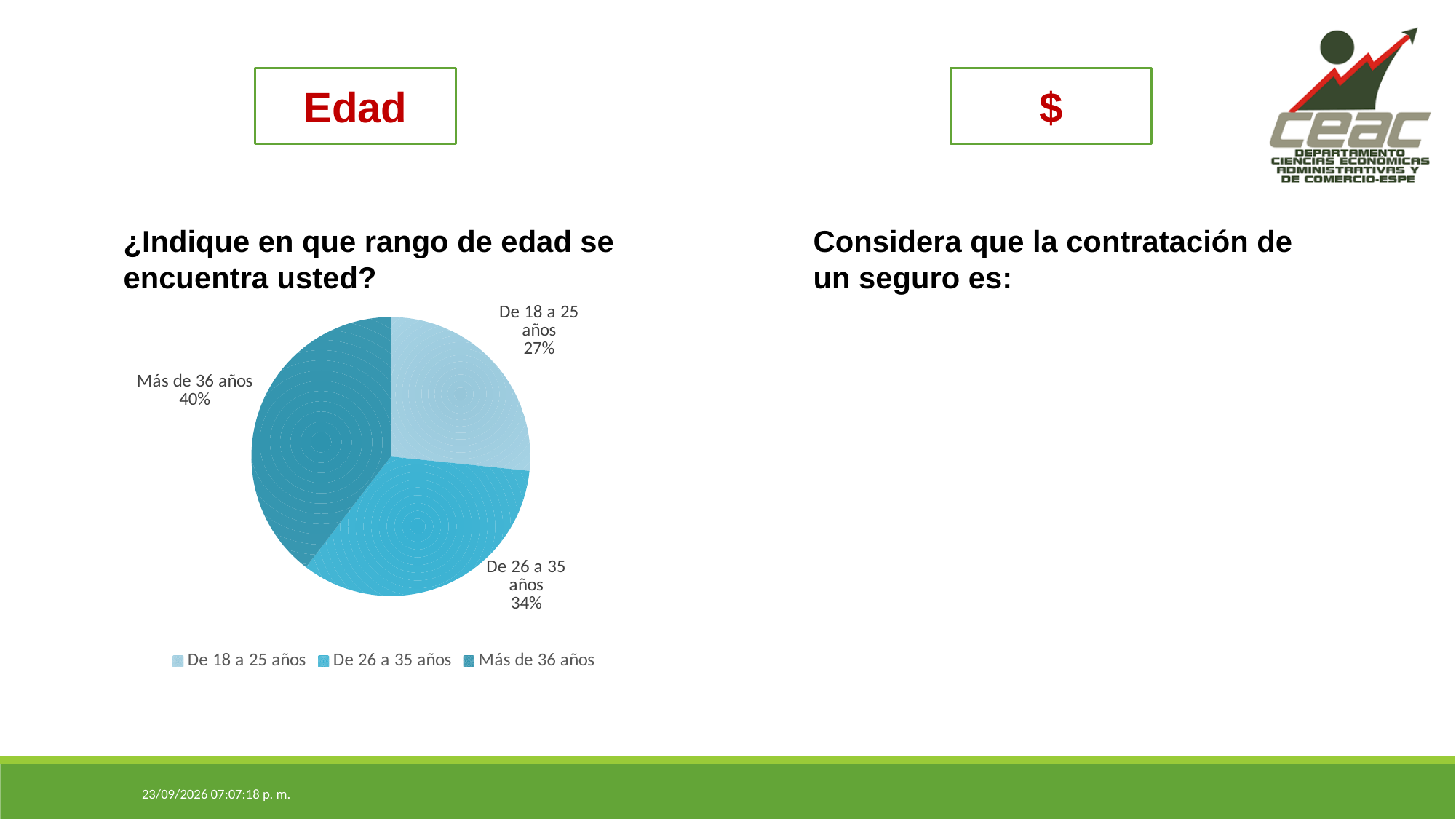
How many entries does the legend of the pie chart list? 3 What share of the pie chart is 'Más de 36 años'? 40% Which is larger, the share for 'De 26 a 35 años' or 'Más de 36 años'? Más de 36 años What kind of chart is shown on the slide? Pie chart What question is the pie chart answering, according to the heading above it? ¿Indique en que rango de edad se encuentra usted? What is the difference in percentage points between 'De 26 a 35 años' and 'De 18 a 25 años'? 7 What share of the pie chart is 'De 18 a 25 años'? 27% Which age range has the largest slice in the pie chart? Más de 36 años Which age range has the smallest slice in the pie chart? De 18 a 25 años How many slices does the pie chart have? 3 What is the difference in percentage points between 'Más de 36 años' and 'De 18 a 25 años'? 13 What share of the pie chart is 'De 26 a 35 años'? 34%